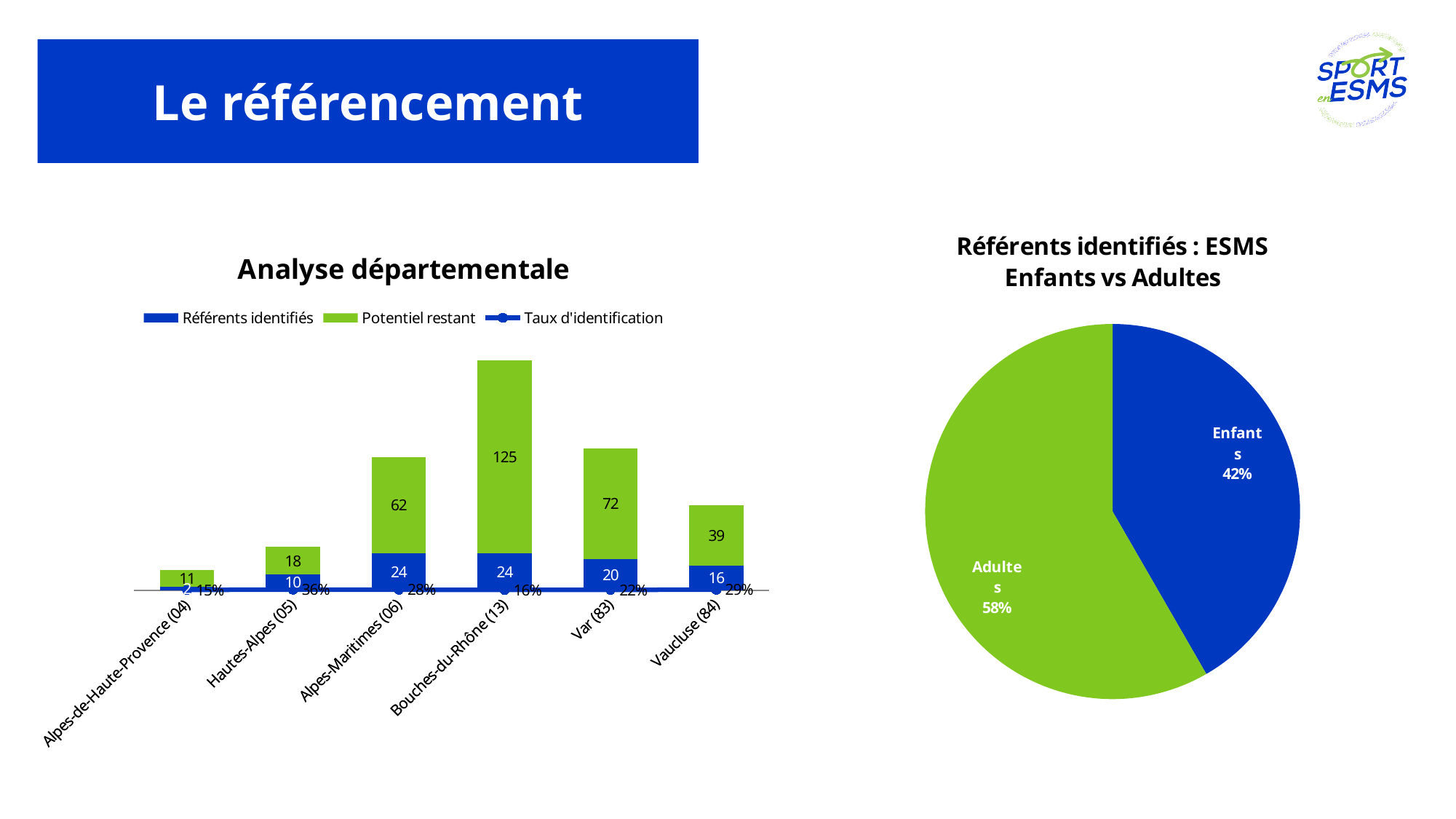
How many series does the legend of the 'Analyse départementale' chart list? 3 In the 'Référents identifiés : ESMS Enfants vs Adultes' chart, what share of the pie is Adultes? 58% In the 'Analyse départementale' chart, which department has the lowest Taux d'identification? Alpes-de-Haute-Provence (04) In the 'Analyse départementale' chart, which has more Référents identifiés: Hautes-Alpes (05) or Vaucluse (84)? Vaucluse (84) In the 'Analyse départementale' chart, what is the total height of the stacked bar for Alpes-Maritimes (06) (Référents identifiés plus Potentiel restant)? 86 In the 'Analyse départementale' chart, what is the Taux d'identification for Hautes-Alpes (05)? 36% In the 'Analyse départementale' chart, how many Référents identifiés are shown for Var (83)? 20 In the 'Analyse départementale' chart, which department has the highest Potentiel restant? Bouches-du-Rhône (13) In the 'Analyse départementale' chart, what is the difference between the Potentiel restant of Var (83) and Vaucluse (84)? 33 What kind of chart is 'Référents identifiés : ESMS Enfants vs Adultes'? Pie chart How many departments are shown on the x axis of the 'Analyse départementale' chart? 6 In the 'Analyse départementale' chart, what is the Potentiel restant value for Bouches-du-Rhône (13)? 125